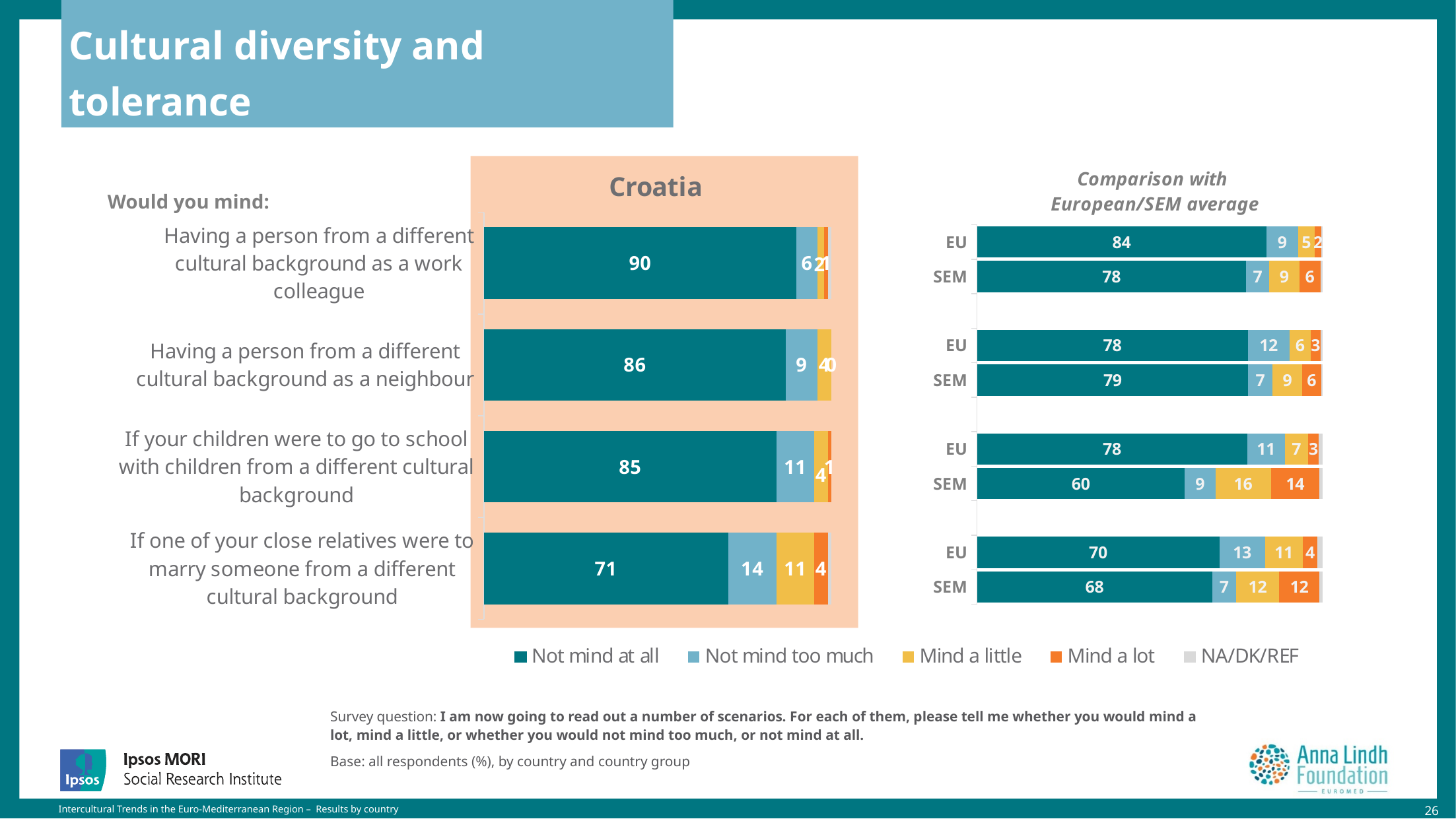
In the Croatia chart, what is the difference between the 'Not mind at all' values for the work colleague scenario and the close relative marrying scenario? 19 In the Croatia chart, what is the 'Mind a little' value for the close relative marrying scenario? 11 In the Comparison with European/SEM average chart, what is the 'Not mind at all' value for the SEM bar in the third EU/SEM pair from the top? 60 In the Croatia chart, is the 'Not mind too much' value larger for the close relative marrying scenario or the children at school scenario? Close relative marrying scenario In the Croatia chart, which scenario has the lowest 'Not mind at all' value? If one of your close relatives were to marry someone from a different cultural background In the Croatia chart, which scenario has the highest 'Not mind at all' value? Having a person from a different cultural background as a work colleague How many series does the legend list? 5 What kind of chart is the Croatia chart? Stacked bar chart In the Croatia chart, what percentage would 'Not mind at all' having a person from a different cultural background as a work colleague? 90 In the Croatia chart, what is the 'Not mind at all' value for one of your close relatives marrying someone from a different cultural background? 71 In the Comparison with European/SEM average chart, what is the 'Not mind at all' value for the EU bar in the top pair? 84 In the Comparison with European/SEM average chart, what is the 'Mind a lot' value for the SEM bar in the third EU/SEM pair from the top? 14